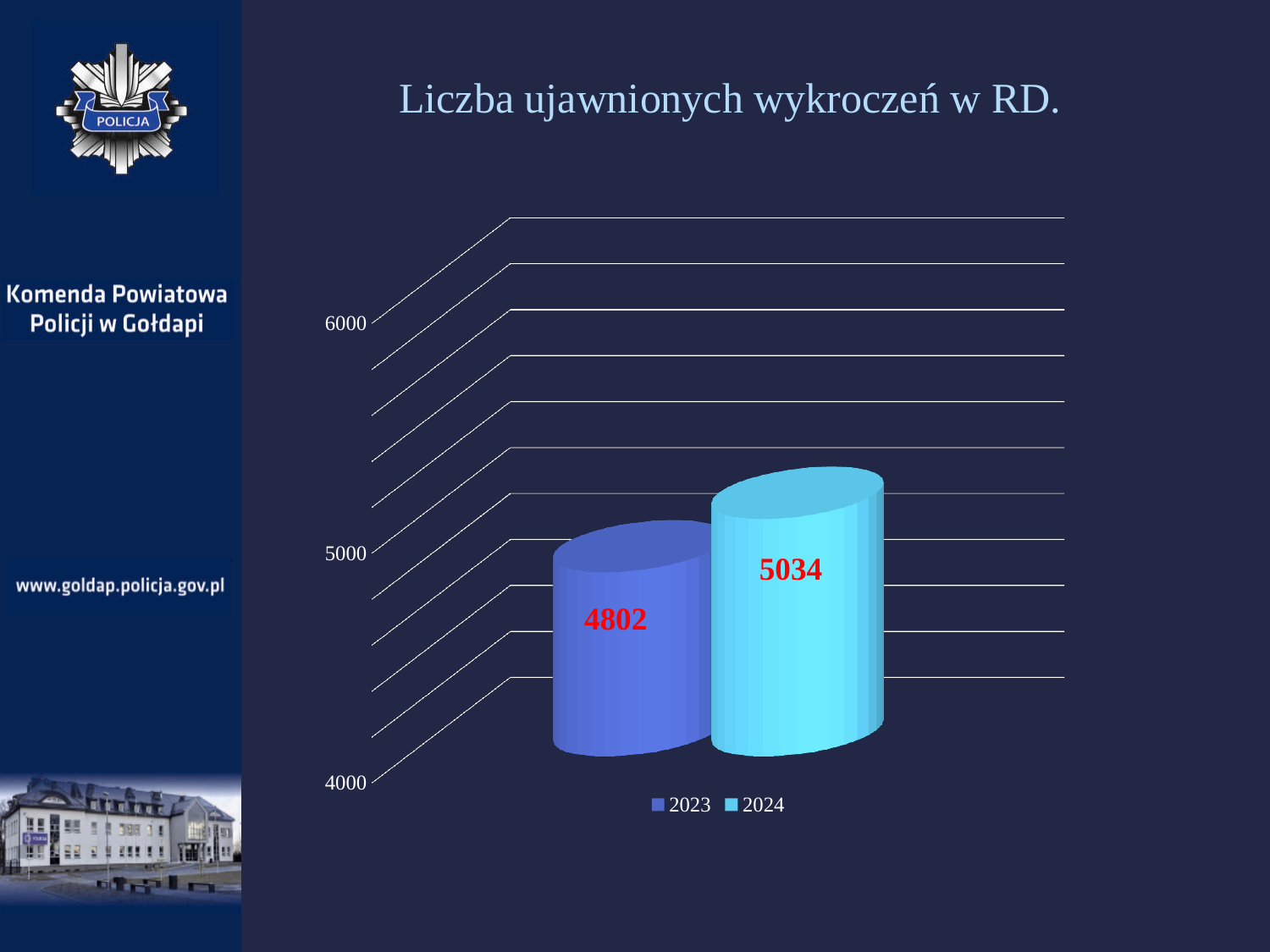
Did the value rise or fall from 2023 to 2024? rise What is the value for 2024? 5034 What is the difference between the 2024 and 2023 values? 232 What is the total of the 2023 and 2024 values? 9836 Which year has the lower value? 2023 How many series does the legend list? 2 What kind of chart is shown on the slide? bar chart Is the value for 2024 greater or less than 5000? greater Is the value for 2023 greater or less than 5000? less Which year has the higher value? 2024 What is the value for 2023? 4802 What is the title of the chart? Liczba ujawnionych wykroczeń w RD.